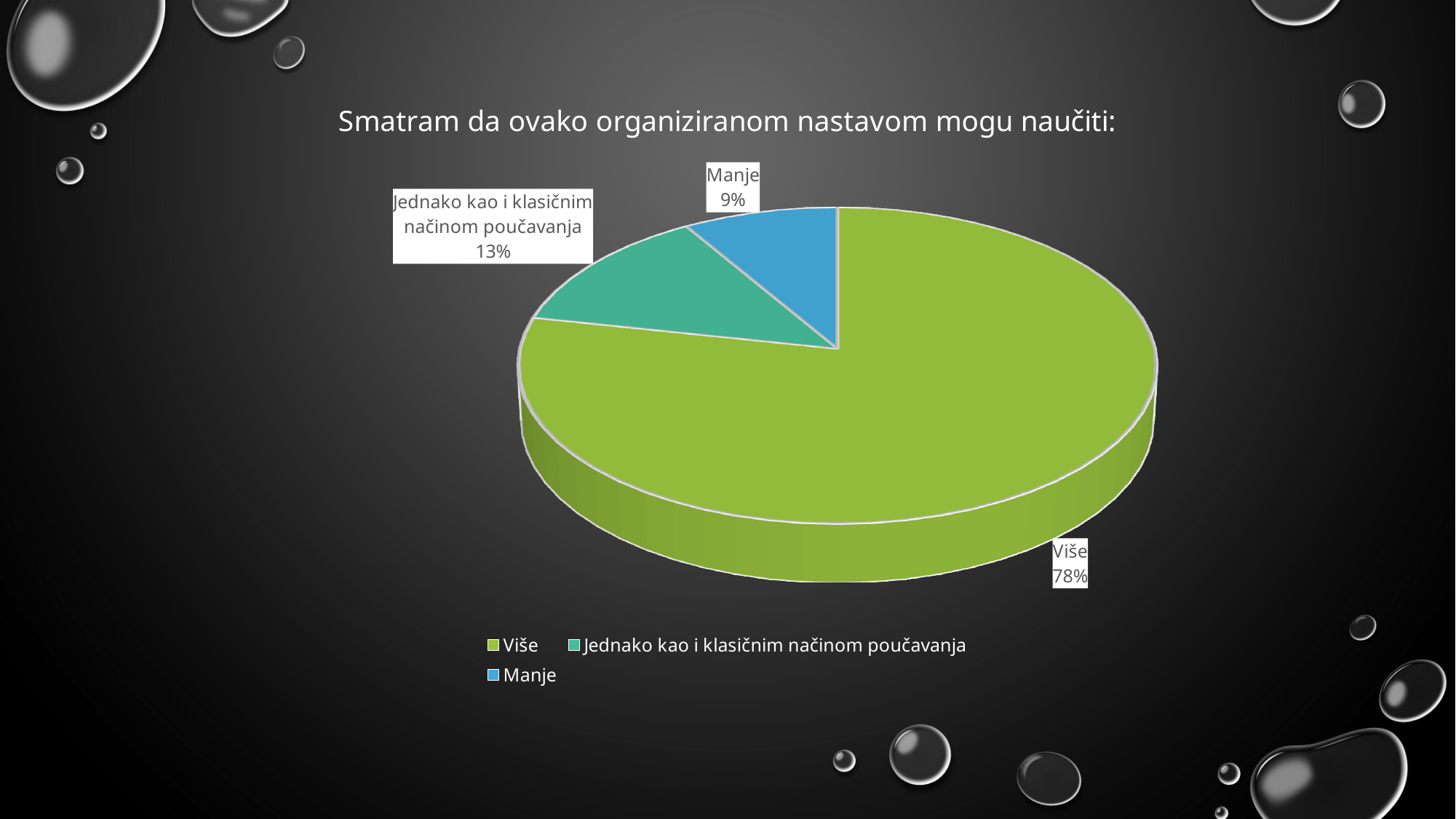
How many slices does the pie chart have? 3 What percentage is shown for "Više"? 78% What is the chart's title? Smatram da ovako organiziranom nastavom mogu naučiti: What percentage is shown for "Manje"? 9% Which category has the smallest share of the pie? Manje Which category has the largest share of the pie? Više What percentage is shown for "Jednako kao i klasičnim načinom poučavanja"? 13% What is the difference in percentage points between "Jednako kao i klasičnim načinom poučavanja" and "Manje"? 4 What type of chart is shown on the slide? Pie chart What is the difference in percentage points between "Više" and "Manje"? 69 Which is larger, the share for "Jednako kao i klasičnim načinom poučavanja" or the share for "Manje"? Jednako kao i klasičnim načinom poučavanja What colour is the "Manje" slice? Blue